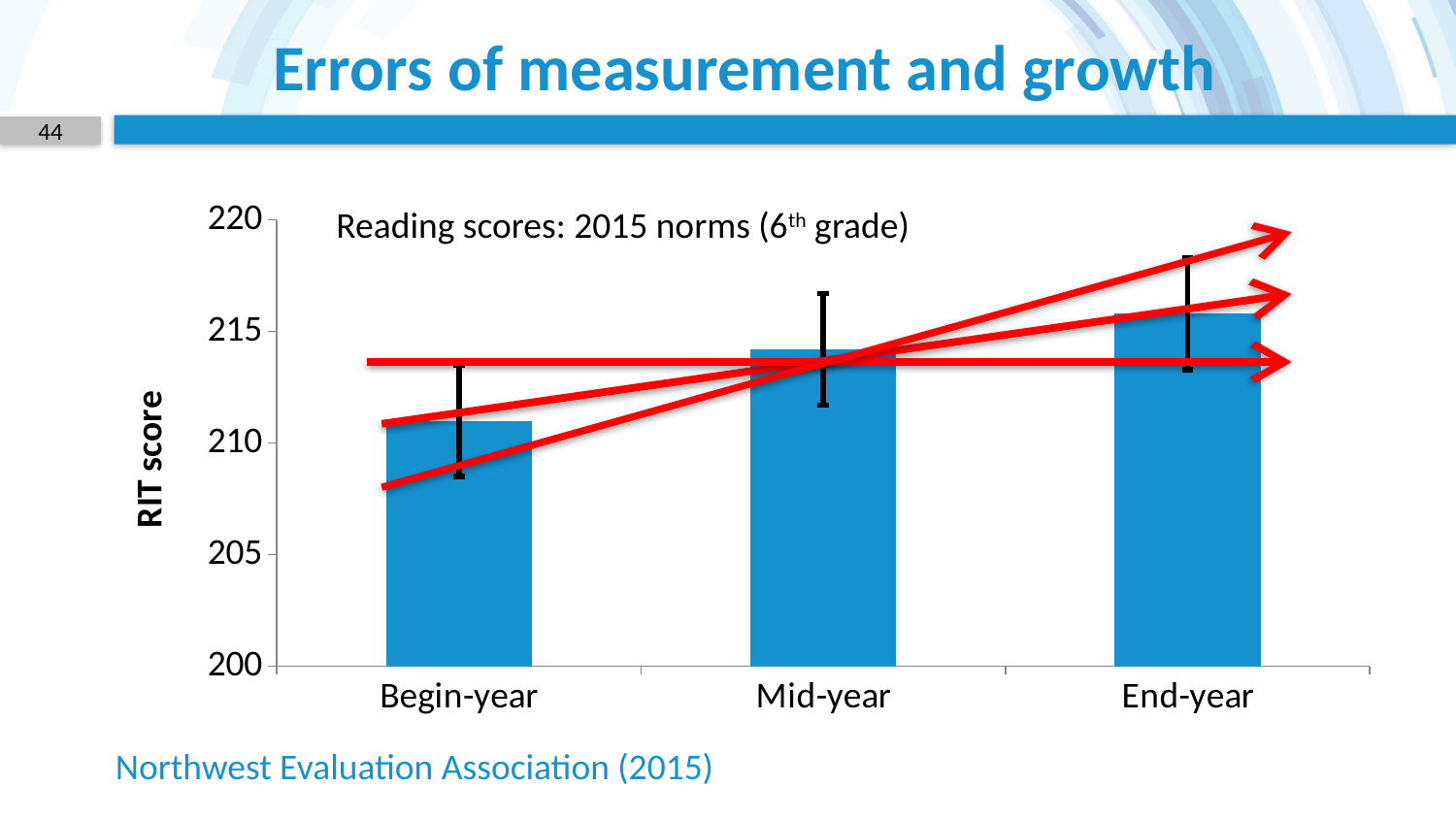
Which category has the lowest RIT score? Begin-year How many categories are plotted on the x axis? 3 What kind of chart is shown on the slide? bar chart Which category has the highest RIT score? End-year Do the RIT scores rise or fall from Begin-year to End-year? rise What is the title of the chart? Reading scores: 2015 norms (6th grade) Is the value for Mid-year greater or less than 210? greater Which is larger, the RIT score for Mid-year or for Begin-year? Mid-year Is the value for End-year greater or less than 215? greater Is the value for Mid-year greater or less than 215? less What is the label on the y axis? RIT score